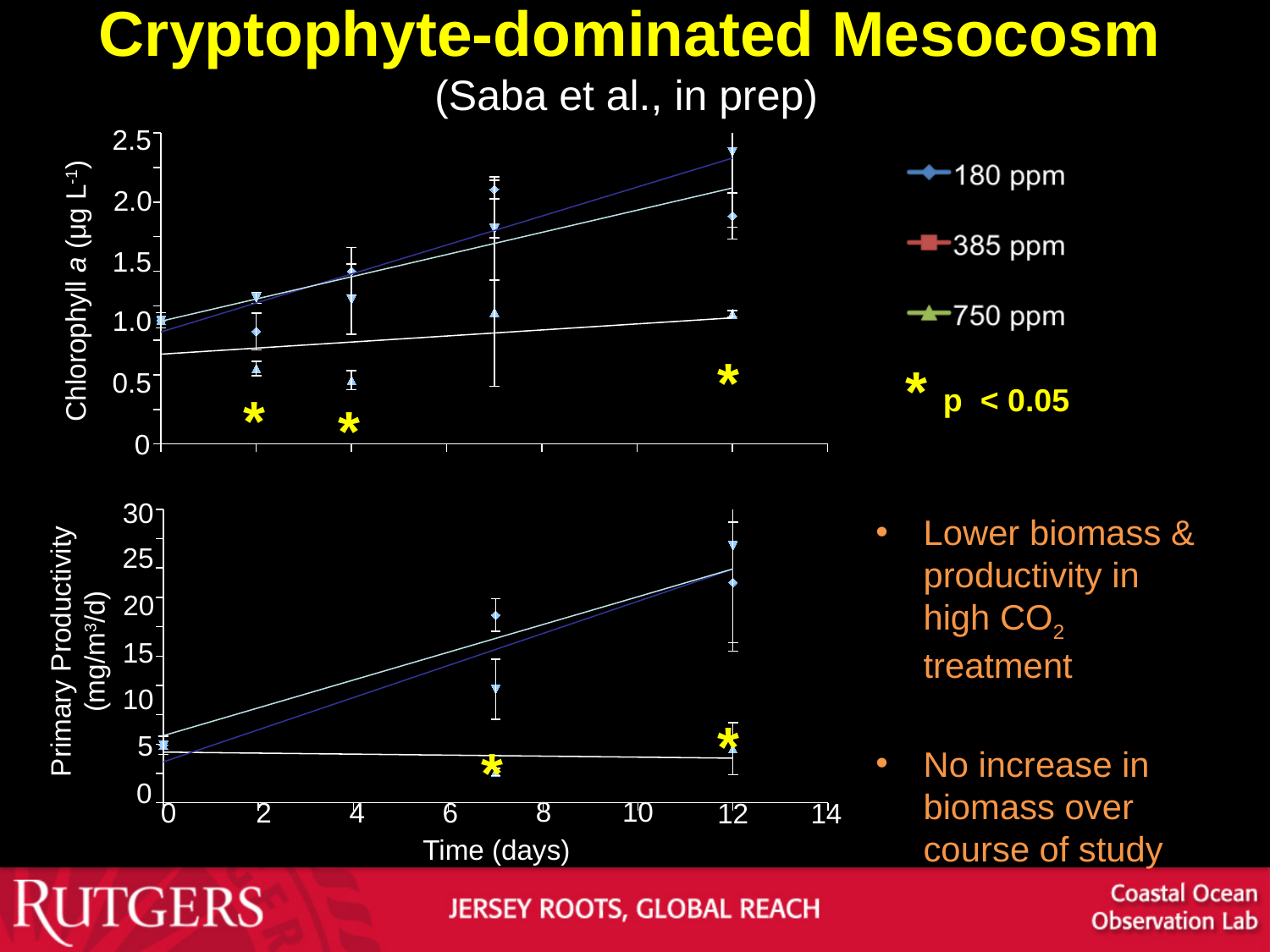
On the top chart (Chlorophyll a), is the value for 385 ppm at day 12 greater or less than 2.0? greater On the bottom chart (Primary Productivity), does the 180 ppm trend line rise or fall over time? rise On the bottom chart (Primary Productivity), which series has the lowest value at day 12? 750 ppm On the bottom chart (Primary Productivity), which is larger at day 7: the 180 ppm value or the 750 ppm value? 180 ppm On the top chart (Chlorophyll a), which series has the highest value at day 12? 385 ppm On the top chart (Chlorophyll a), is the value for 180 ppm at day 12 greater or less than 1.5? greater On the top chart (Chlorophyll a), how many series does the legend list? 3 On the top chart (Chlorophyll a), which is larger at day 12: the 180 ppm value or the 750 ppm value? 180 ppm On the bottom chart (Primary Productivity), is the value for 750 ppm at day 12 greater or less than 10? less What is the x-axis label shared by the two charts? Time (days) On the top chart (Chlorophyll a), does the 385 ppm trend line rise or fall over time? rise